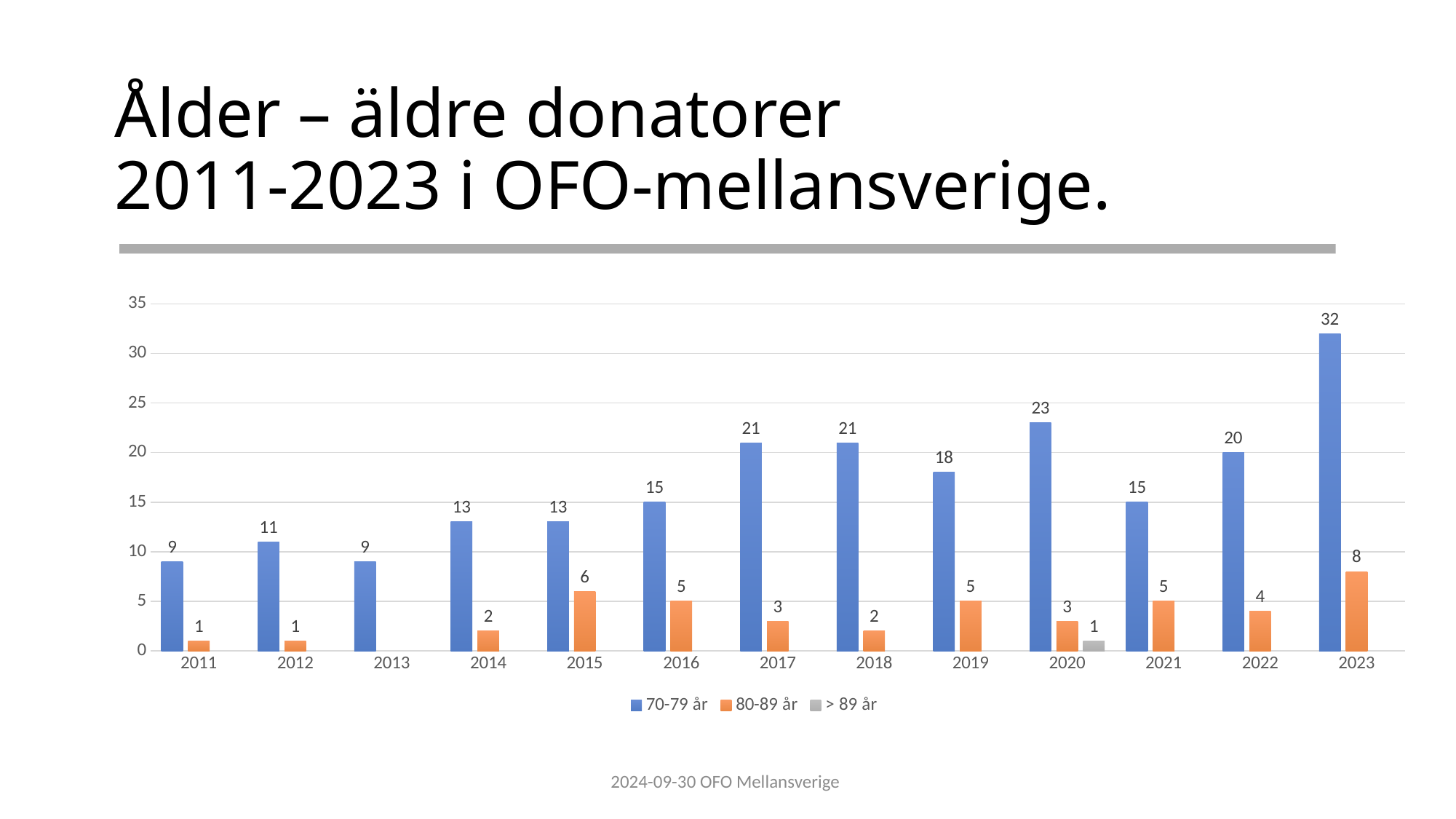
Which year has the highest value for the 70-79 år series? 2023 How many years are shown on the x axis? 13 What is the difference between the 70-79 år values in 2023 and 2020? 9 What is the value for the > 89 år series in 2020? 1 What colour are the bars for the 80-89 år series? orange Which is larger: the 70-79 år value in 2019 or in 2022? 2022 What is the value for the 80-89 år series in 2015? 6 What kind of chart is shown on the slide? bar chart What is the total of the 70-79 år and 80-89 år values in 2016? 20 How many series does the legend list? 3 Which year has the highest value for the 80-89 år series? 2023 What is the value for the 70-79 år series in 2023? 32